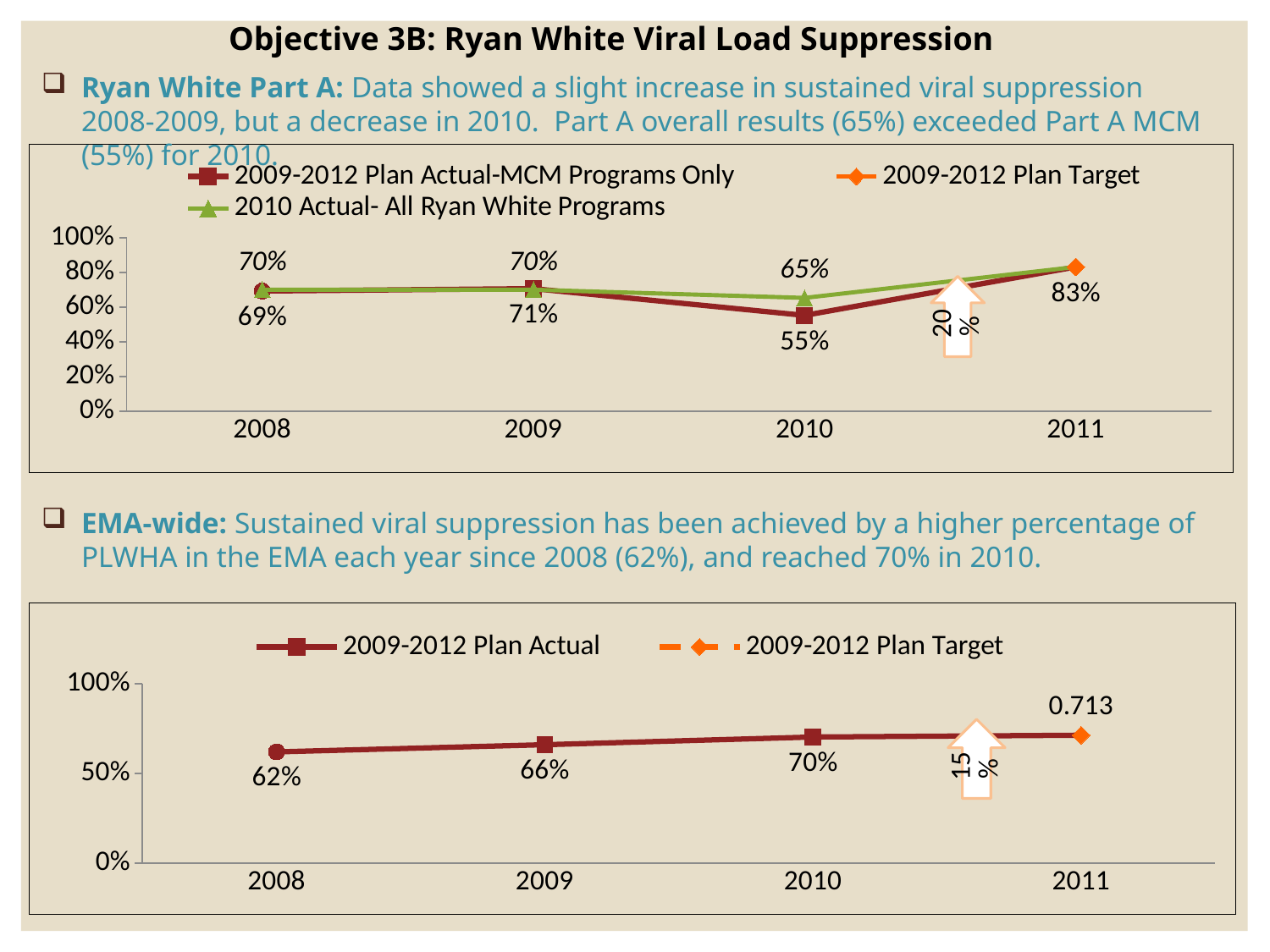
In the top chart, which series has the higher value in 2010: MCM Programs Only or All Ryan White Programs? 2010 Actual- All Ryan White Programs In the top chart, what is the value for the 2009-2012 Plan Actual-MCM Programs Only series in 2009? 71% In the top chart, how many series does the legend list? 3 In the bottom chart, what is the 2009-2012 Plan Actual value for 2008? 62% In the top chart, what is the value for the 2009-2012 Plan Actual-MCM Programs Only series in 2010? 55% In the bottom chart, does the 2009-2012 Plan Actual series rise or fall from 2008 to 2010? rise In the top chart, what is the difference between the All Ryan White Programs value and the MCM Programs Only value in 2010? 10% What kind of chart is the bottom chart? line chart In the top chart, what is the value for the 2010 Actual- All Ryan White Programs series in 2010? 65% In the bottom chart, what is the 2009-2012 Plan Target value shown for 2011? 0.713 In the top chart, what is the 2009-2012 Plan Target value shown for 2011? 83% In the bottom chart, what is the 2009-2012 Plan Actual value for 2010? 70%